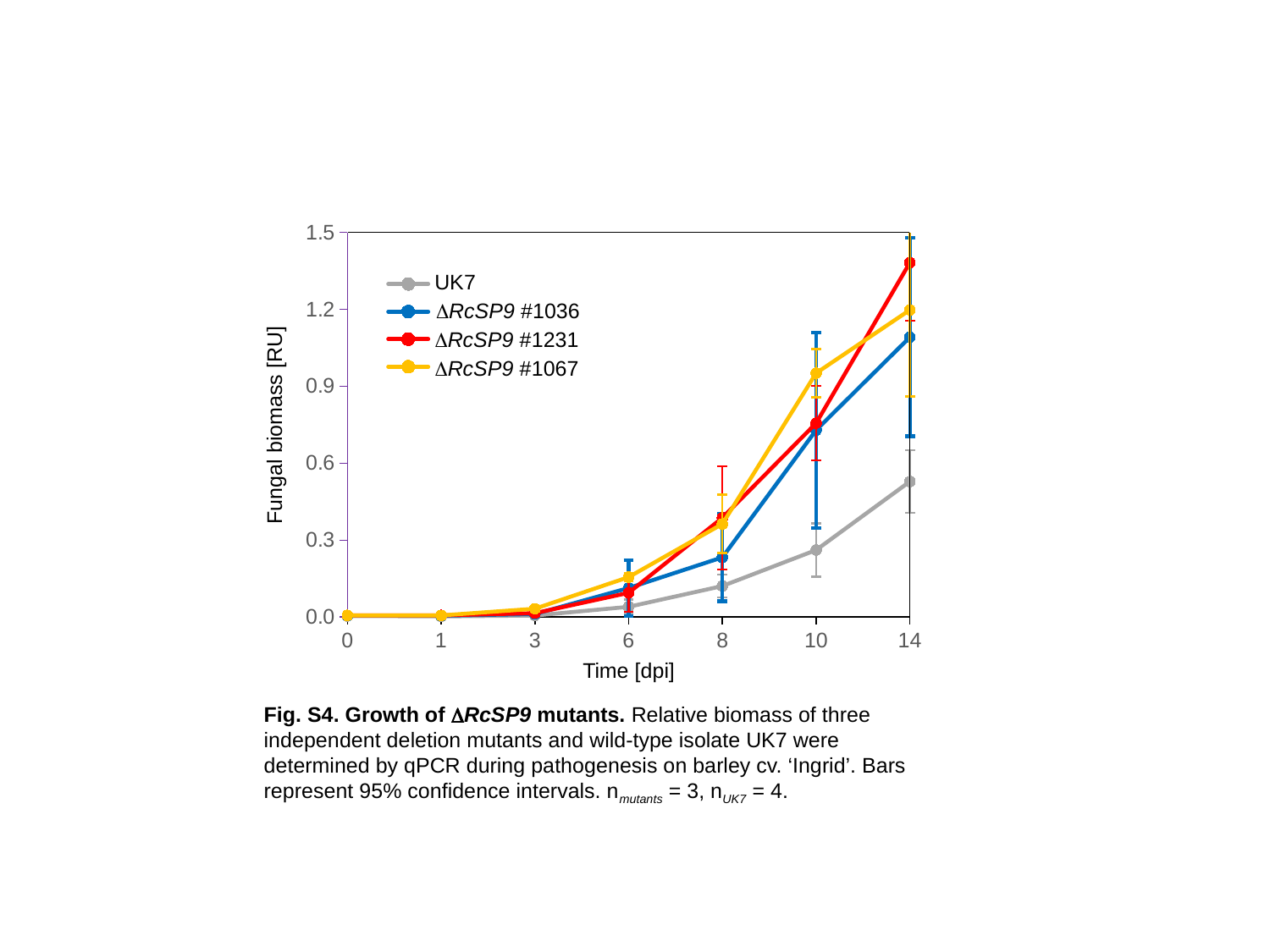
Which series has the lowest fungal biomass at 14 dpi? UK7 How many time points are plotted along the x axis? 7 Does the fungal biomass of UK7 rise or fall over time? rise Is the fungal biomass of ΔRcSP9 #1231 at 14 dpi greater or less than 1.2? greater What kind of chart is shown on the slide? line chart How many series does the legend list? 4 Is the fungal biomass of UK7 at 14 dpi greater or less than 0.9? less Which series has the highest fungal biomass at 14 dpi? ΔRcSP9 #1231 What is the label of the y axis? Fungal biomass [RU] Which series has the highest fungal biomass at 10 dpi? ΔRcSP9 #1067 Is the fungal biomass of ΔRcSP9 #1036 at 14 dpi greater or less than 0.9? greater At 10 dpi, which has the larger fungal biomass, ΔRcSP9 #1067 or UK7? ΔRcSP9 #1067